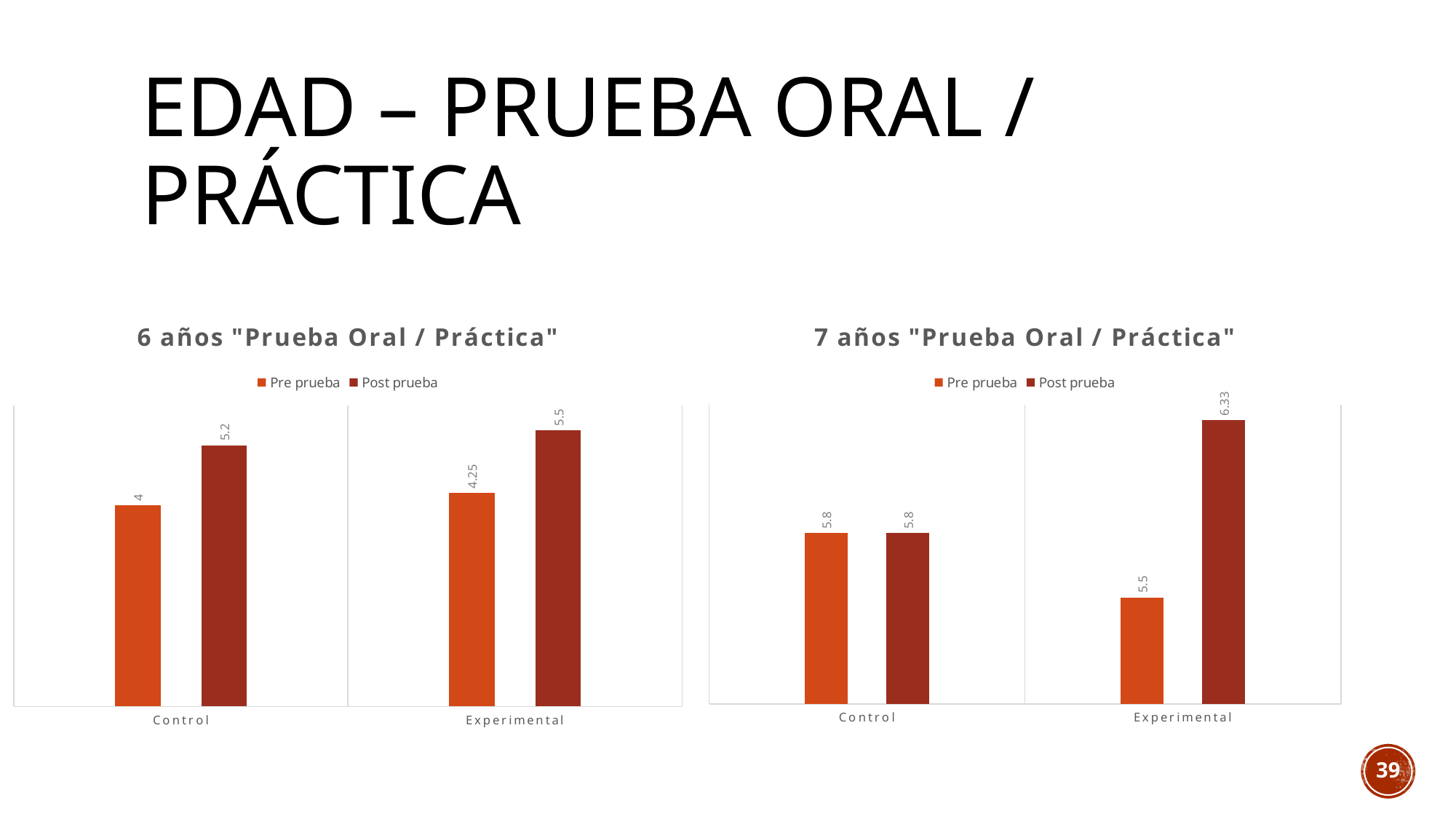
How many categories are shown on the x axis of the chart titled '6 años "Prueba Oral / Práctica"'? 2 In the chart titled '6 años "Prueba Oral / Práctica"', what is the Post prueba value for Experimental? 5.5 In the chart titled '6 años "Prueba Oral / Práctica"', what is the Pre prueba value for Control? 4 In the chart titled '7 años "Prueba Oral / Práctica"', which is larger: the Pre prueba value for Control or the Pre prueba value for Experimental? Control In the chart titled '6 años "Prueba Oral / Práctica"', which bar has the highest value? Experimental Post prueba In the chart titled '7 años "Prueba Oral / Práctica"', what is the Post prueba value for Experimental? 6.33 How many series does the legend list in the chart titled '7 años "Prueba Oral / Práctica"'? 2 What kind of chart is the chart titled '7 años "Prueba Oral / Práctica"'? Bar chart In the chart titled '7 años "Prueba Oral / Práctica"', what is the Pre prueba value for Control? 5.8 In the chart titled '7 años "Prueba Oral / Práctica"', what is the difference between the Post prueba and Pre prueba values for Experimental? 0.83 In the chart titled '6 años "Prueba Oral / Práctica"', what is the difference between the Post prueba and Pre prueba values for Control? 1.2 In the chart titled '6 años "Prueba Oral / Práctica"', which bar has the lowest value? Control Pre prueba